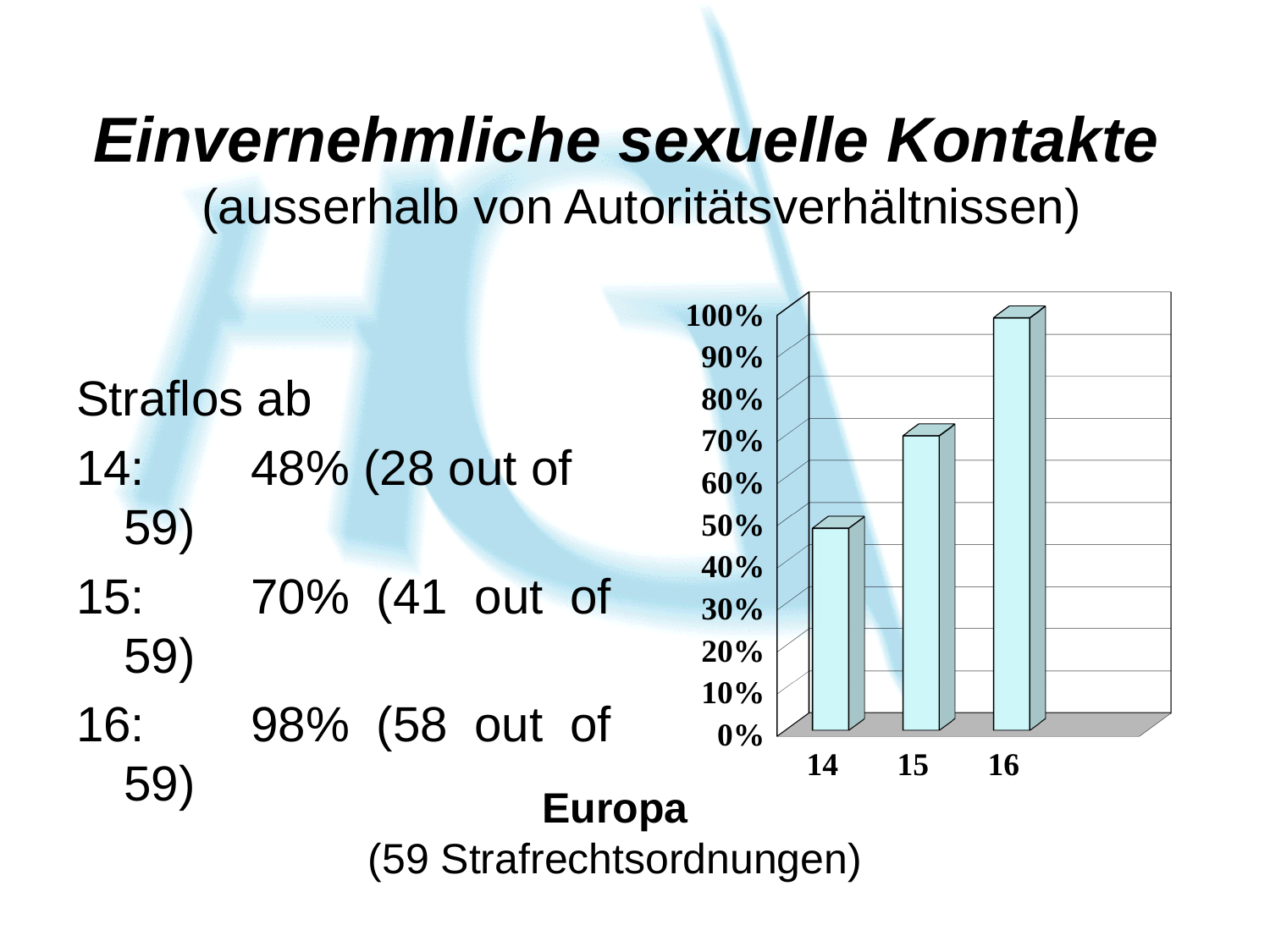
What is the difference between the values for age 16 and age 14? 50% Which age category has the lowest bar in the chart? 14 What is the value for age 14 in the chart? 48% What kind of chart is shown on the slide? bar chart Is the value for age 16 greater or less than 90%? greater Which is larger, the value for age 15 or the value for age 16? 16 What is the value for age 15 in the chart? 70% What is the value for age 16 in the chart? 98% Is the value for age 14 greater or less than 50%? less How many bars does the chart show? 3 Which age category has the highest bar in the chart? 16 Do the values rise or fall as the age increases along the x axis? rise